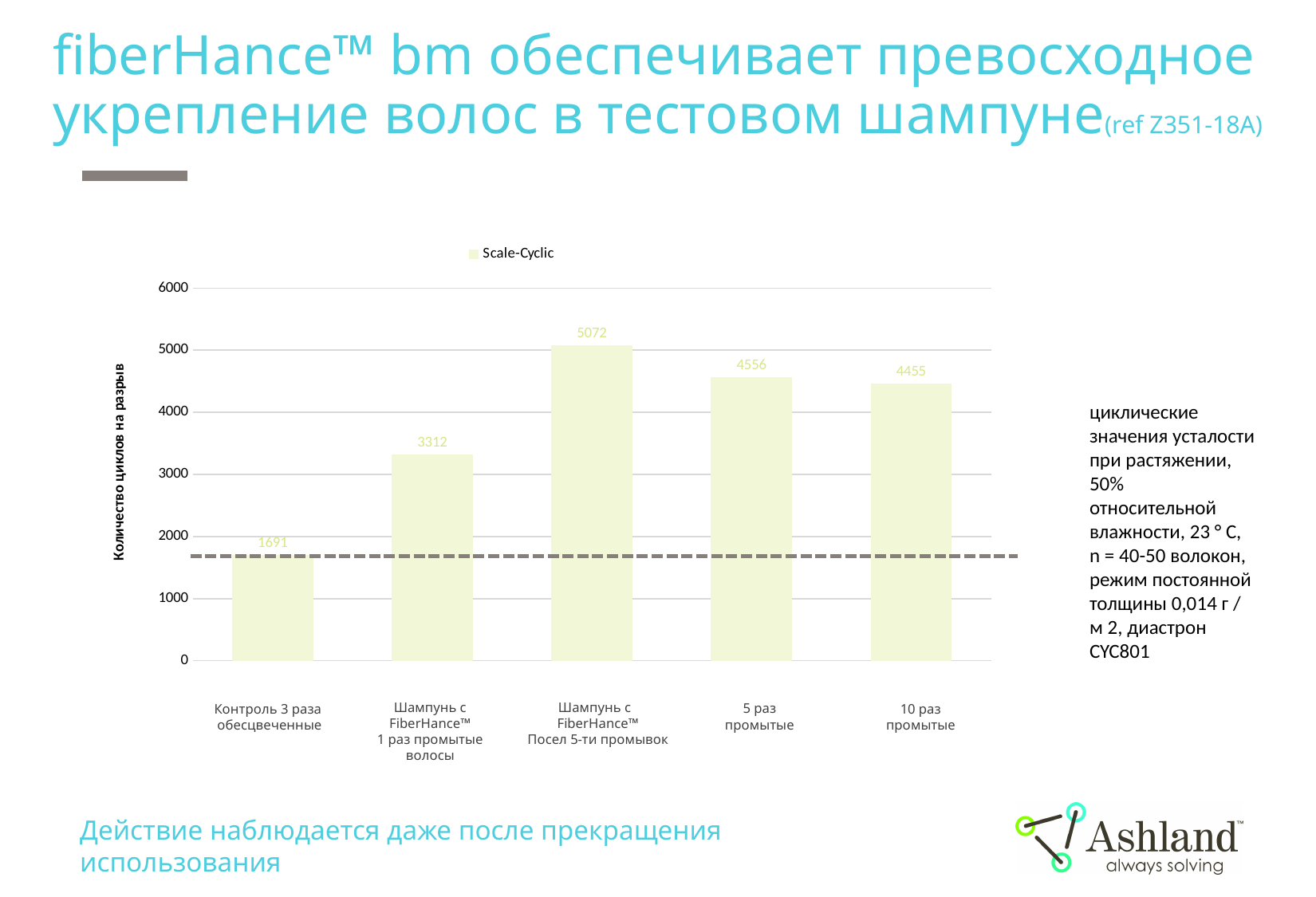
What is the value for "Шампунь с FiberHance™ 1 раз промытые волосы"? 3312 Is the value for "Контроль 3 раза обесцвеченные" greater or less than 2000? less What is the difference between the values for "5 раз промытые" and "10 раз промытые"? 101 Which is larger, the value for "Шампунь с FiberHance™ 1 раз промытые волосы" or the value for "5 раз промытые"? 5 раз промытые What series name does the legend show? Scale-Cyclic What is the value for "Контроль 3 раза обесцвеченные"? 1691 Which category has the lowest value? Контроль 3 раза обесцвеченные How many categories are shown on the x axis? 5 What is the value for "Шампунь с FiberHance™ Посел 5-ти промывок"? 5072 Which category has the highest value? Шампунь с FiberHance™ Посел 5-ти промывок What kind of chart is shown on the slide? bar chart What is the value for "10 раз промытые"? 4455